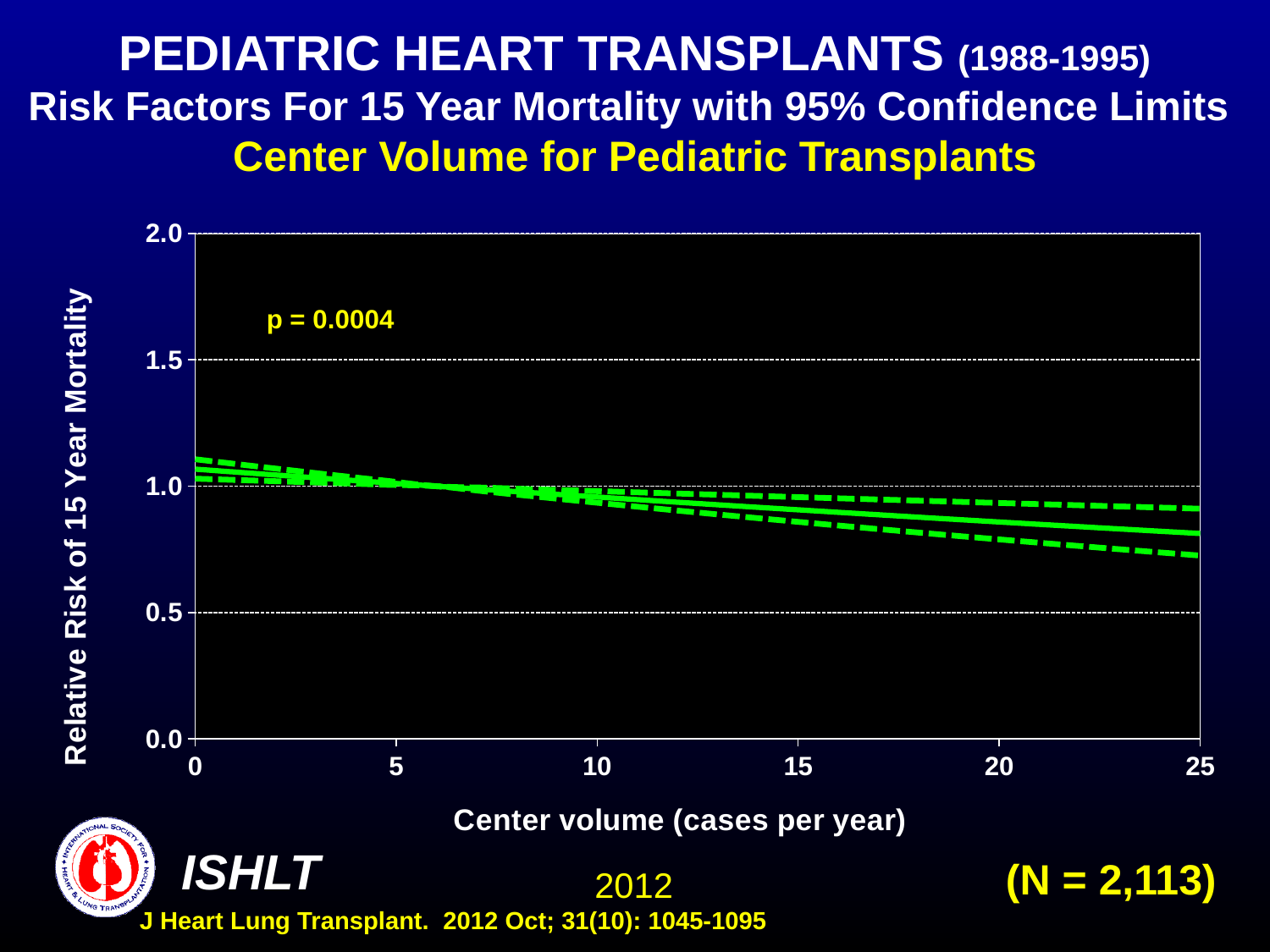
What p-value is printed on the chart? p = 0.0004 How many tick labels are shown on the x axis? 6 What is the label of the x axis? Center volume (cases per year) Is the upper dashed confidence limit at a center volume of 25 cases per year greater or less than 1.0? less How many lines are plotted on the chart? 3 Is the lower dashed confidence limit at a center volume of 25 cases per year greater or less than 0.5? greater Is the relative risk shown by the solid line at a center volume of 20 cases per year greater or less than 1.0? less What kind of chart is shown on the slide? line chart Does the relative risk of 15 year mortality rise or fall as center volume increases? fall